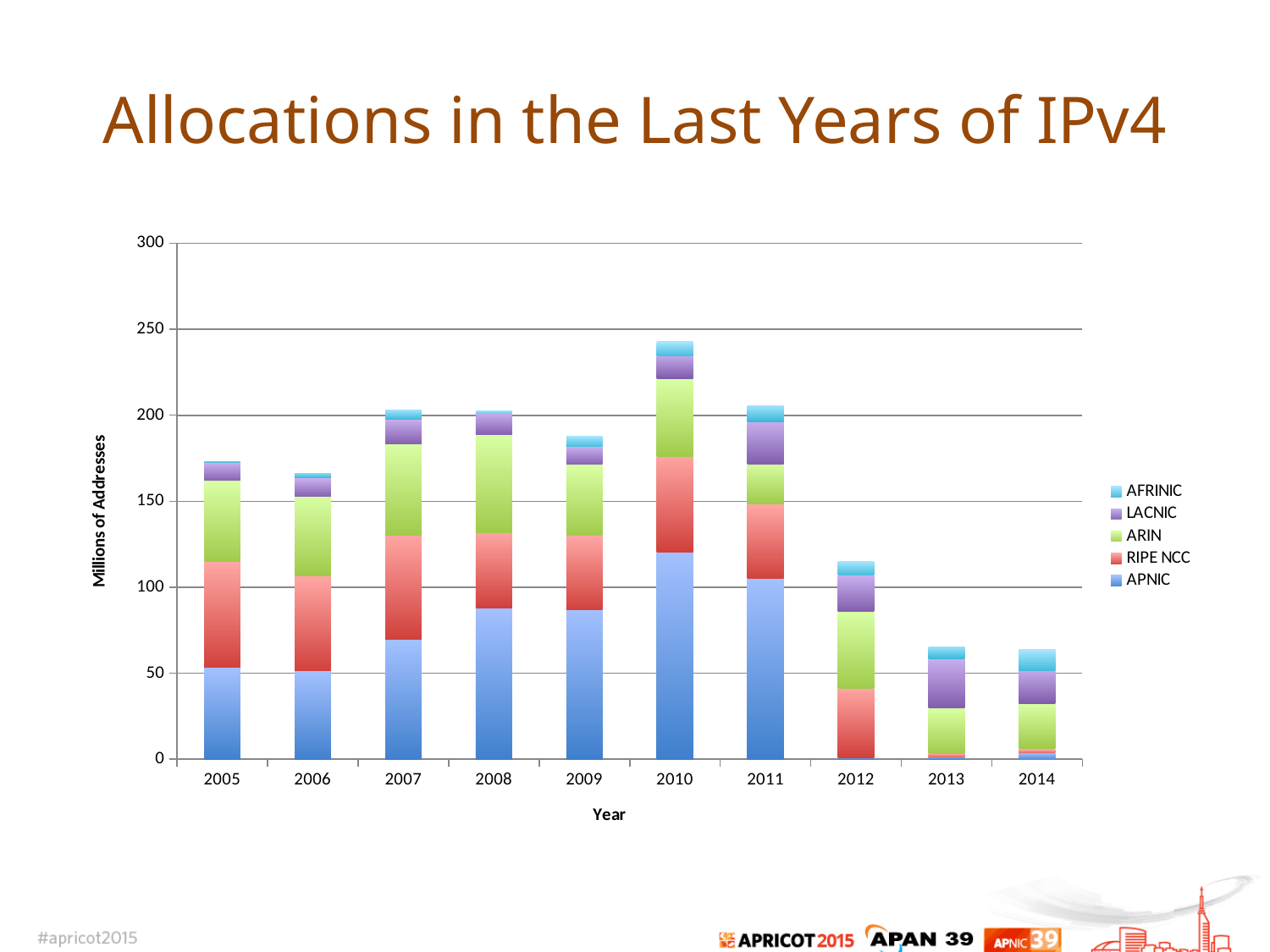
Is the total value for 2006 greater or less than 200? less Which year has the highest total allocation in the chart? 2010 Which year has the larger total allocation, 2010 or 2011? 2010 Do the total allocations rise or fall from 2011 to 2014? fall How many series does the chart's legend list? 5 What kind of chart is shown on the slide? stacked bar chart How many years are shown on the x axis of the chart? 10 Is the total value for 2010 greater or less than 200? greater Is the total value for 2013 greater or less than 100? less What is the label of the chart's vertical axis? Millions of Addresses What is the title of the chart on the slide? Allocations in the Last Years of IPv4